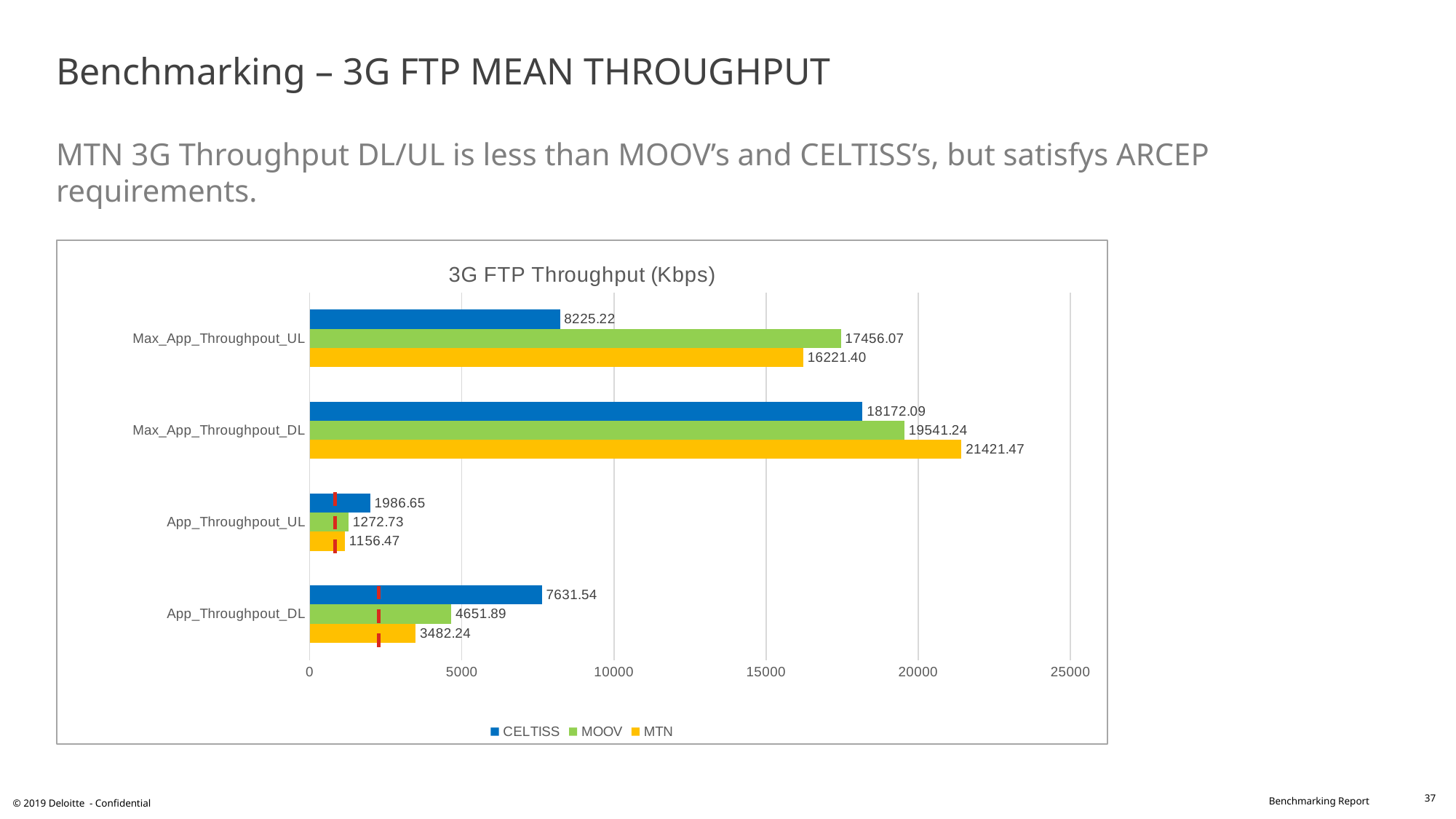
What is the MOOV value for Max_App_Throughpout_UL? 17456.07 What type of chart is shown on the slide? Bar chart What is the difference between the CELTISS and MOOV values for App_Throughpout_DL? 2979.65 What is the CELTISS value for App_Throughpout_DL? 7631.54 What is the MTN value for Max_App_Throughpout_DL? 21421.47 Is the CELTISS value for Max_App_Throughpout_DL greater or less than 15000? greater What is the MTN value for App_Throughpout_UL? 1156.47 Which is larger for Max_App_Throughpout_UL: the CELTISS value or the MTN value? MTN How many categories are shown on the y axis of the chart? 4 Which operator has the highest value for Max_App_Throughpout_DL? MTN Which operator has the lowest value for App_Throughpout_DL? MTN How many series does the legend list? 3